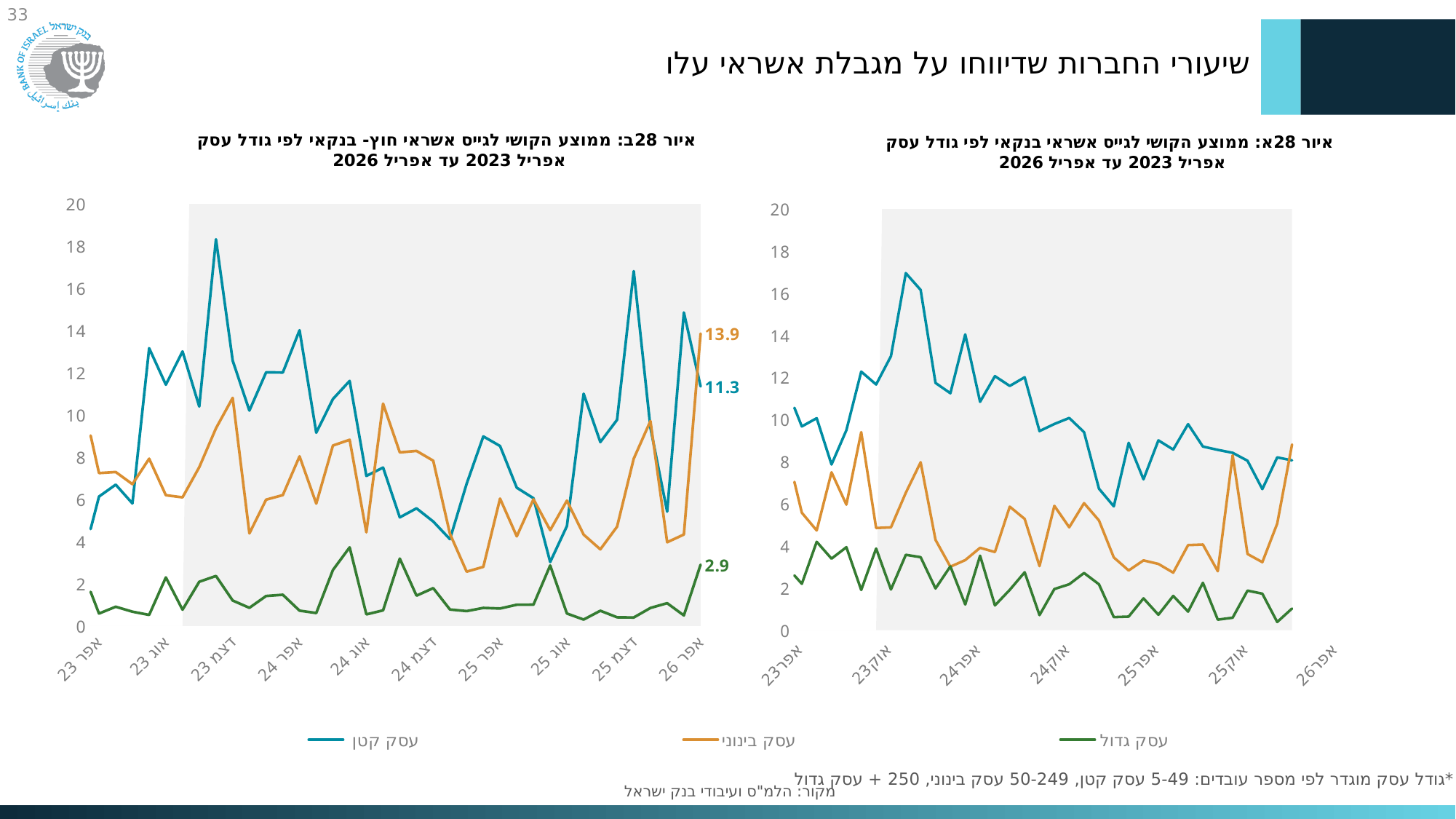
In the left chart (איור 28ב), what is the final value shown for עסק בינוני? 13.9 In the left chart (איור 28ב), what is the final value shown for עסק גדול? 2.9 Which series is drawn in green in the charts? עסק גדול In the left chart (איור 28ב), which final value is larger: עסק קטן or עסק גדול? עסק קטן How many series does the legend list? 3 In the right chart (איור 28א), is the peak value of עסק קטן greater or less than 16? greater In the left chart (איור 28ב), which series has the lowest final value? עסק גדול In the left chart (איור 28ב), what is the difference between the final values of עסק בינוני and עסק קטן? 2.6 In the left chart (איור 28ב), which series has the highest final value? עסק בינוני What kind of chart is used in the right chart (איור 28א)? line chart In the right chart (איור 28א), is the highest value of עסק גדול greater or less than 6? less In the left chart (איור 28ב), what is the final value shown for עסק קטן? 11.3